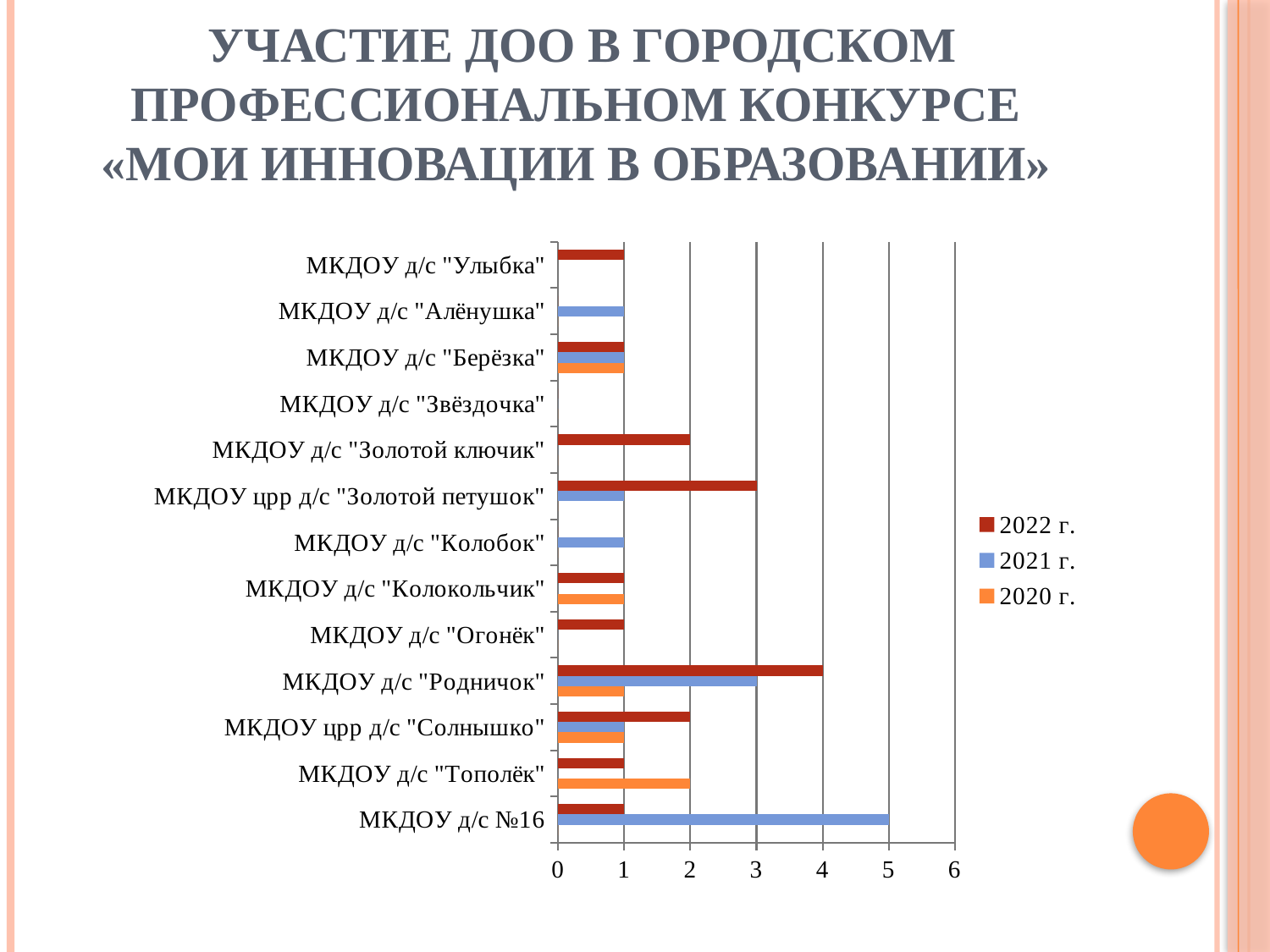
What is the value for МКДОУ д/с "Тополёк" in the 2020 г. series? 2 Which category has the highest value in the 2022 г. series? МКДОУ д/с "Родничок" How many series does the legend list? 3 What is the difference between the 2021 г. value for МКДОУ д/с №16 and the 2021 г. value for МКДОУ д/с "Родничок"? 2 How many categories (institutions) are shown on the chart? 13 What is the value for МКДОУ црр д/с "Золотой петушок" in the 2022 г. series? 3 Which category has the highest value in the 2021 г. series? МКДОУ д/с №16 What is the value for МКДОУ д/с "Родничок" in the 2022 г. series? 4 What kind of chart is shown on the slide? bar chart Which is larger: the 2022 г. value for МКДОУ д/с "Золотой ключик" or the 2022 г. value for МКДОУ црр д/с "Золотой петушок"? МКДОУ црр д/с "Золотой петушок" Which legend entry is shown in orange? 2020 г. What is the value for МКДОУ д/с №16 in the 2021 г. series? 5